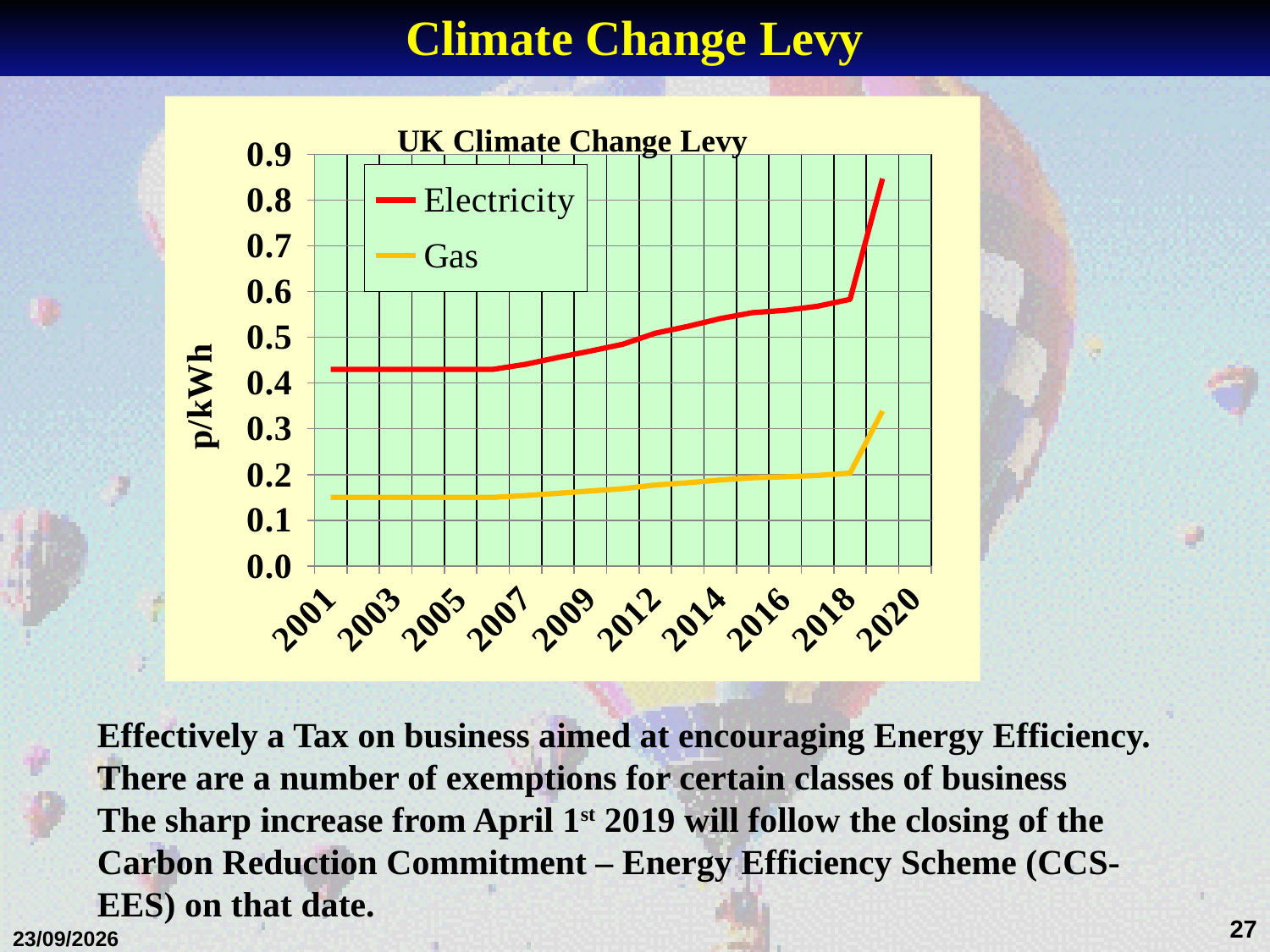
How many series does the legend list? 2 What kind of chart is shown on the slide? line chart What is the title of the chart? UK Climate Change Levy What are the two series named in the legend? Electricity and Gas Is the value for Electricity in 2020 greater or less than 0.8? greater Is the value for Electricity in 2001 greater or less than 0.5? less Does the Electricity line rise or fall from 2001 to 2020? rise Does the Gas line rise or fall from 2001 to 2020? rise In which year does the Electricity series reach its highest value? 2019 Is the value for Gas in 2001 greater or less than 0.2? less Which series has the higher value in 2020, Electricity or Gas? Electricity